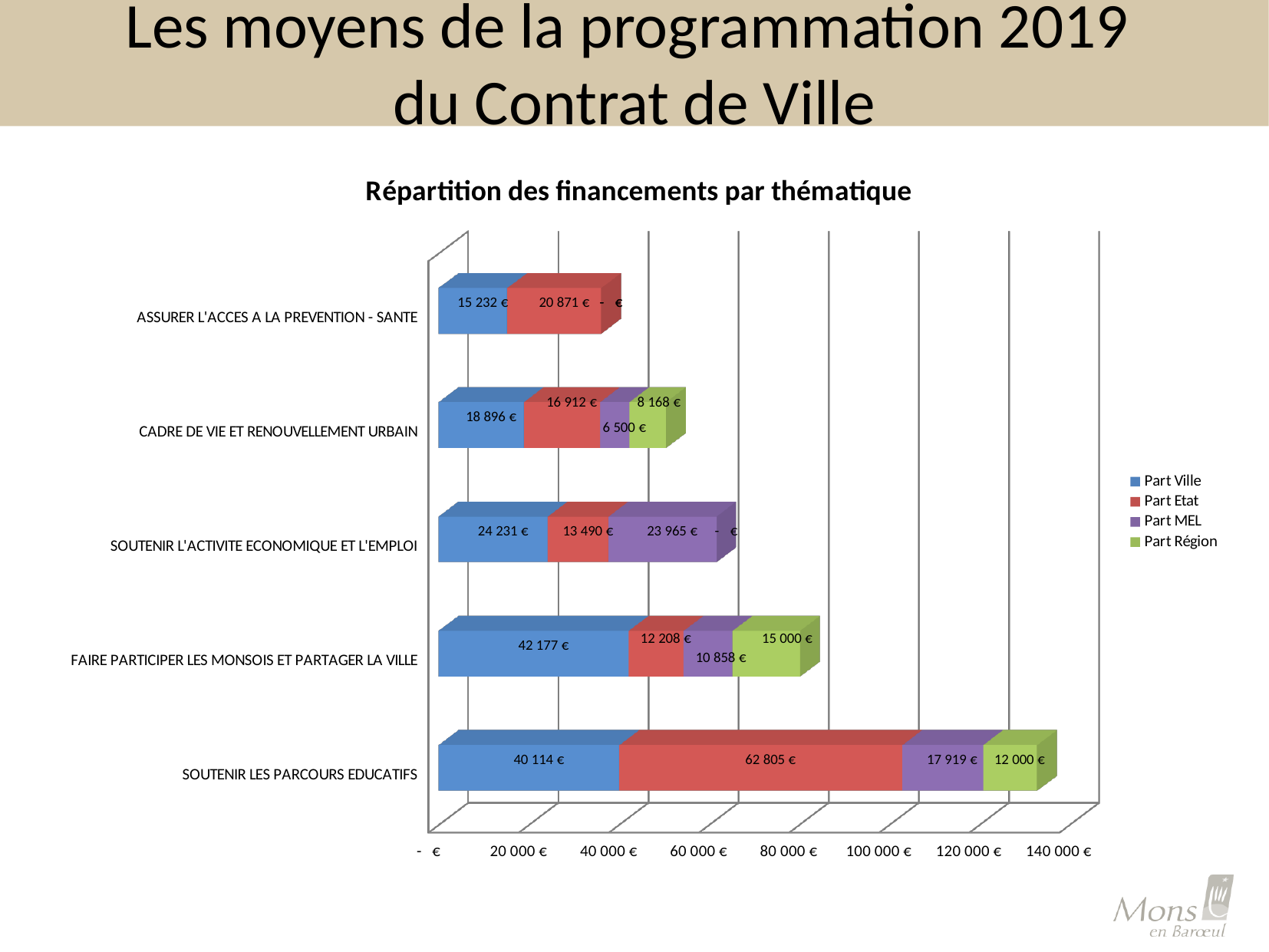
What is the Part Etat value for SOUTENIR LES PARCOURS EDUCATIFS? 62 805 € What is the Part MEL value for SOUTENIR L'ACTIVITE ECONOMIQUE ET L'EMPLOI? 23 965 € What is the Part Région value for CADRE DE VIE ET RENOUVELLEMENT URBAIN? 8 168 € What is the Part Ville value for FAIRE PARTICIPER LES MONSOIS ET PARTAGER LA VILLE? 42 177 € Which category has the shortest total bar? ASSURER L'ACCES A LA PREVENTION - SANTE What kind of chart is shown on the slide? Stacked bar chart What is the difference between the Part Etat and Part Ville values for SOUTENIR LES PARCOURS EDUCATIFS? 22 691 € Is the Part Ville value for SOUTENIR LES PARCOURS EDUCATIFS larger or smaller than the Part Ville value for FAIRE PARTICIPER LES MONSOIS ET PARTAGER LA VILLE? Smaller How many series does the legend list? 4 Which category has the longest total bar? SOUTENIR LES PARCOURS EDUCATIFS What is the total of the stacked bar for SOUTENIR LES PARCOURS EDUCATIFS? 132 838 € How many thematic categories are plotted on the chart? 5